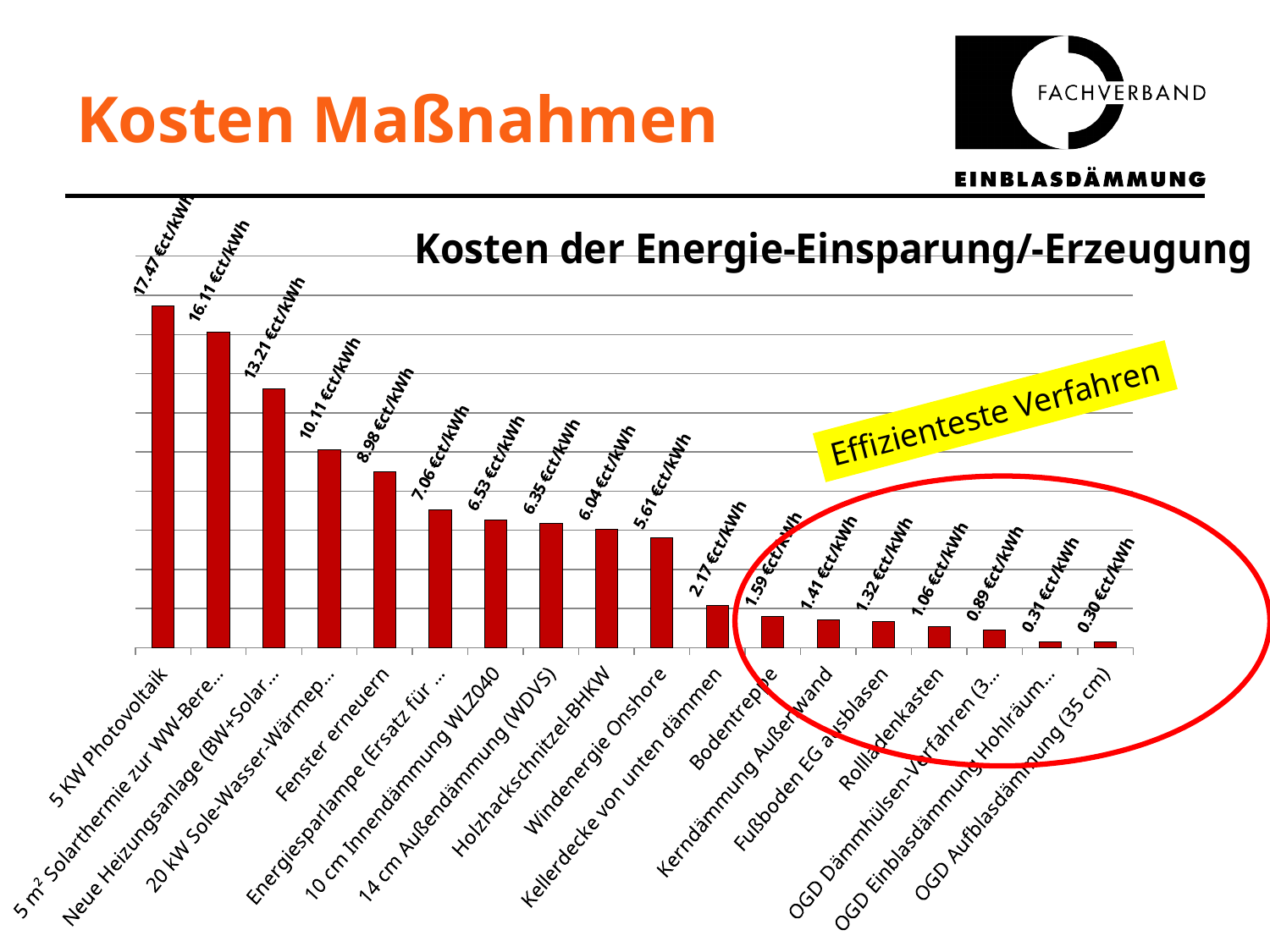
What type of chart is shown on the slide? bar chart What is the title of the chart? Kosten der Energie-Einsparung/-Erzeugung Do the values rise or fall from left to right along the x axis? fall What is the value for Windenergie Onshore? 5.61 €ct/kWh What is the value for Fenster erneuern? 8.98 €ct/kWh How many categories (bars) are shown in the chart? 18 What is the value for Kerndämmung Außenwand? 1.41 €ct/kWh Which has a higher value, 14 cm Außendämmung (WDVS) or Rollladenkasten? 14 cm Außendämmung (WDVS) What is the value for OGD Aufblasdämmung (35 cm)? 0.30 €ct/kWh What is the difference between the values for Holzhackschnitzel-BHKW and Kellerdecke von unten dämmen? 3.87 €ct/kWh Which category has the highest value? 5 KW Photovoltaik What is the value for 5 KW Photovoltaik? 17.47 €ct/kWh